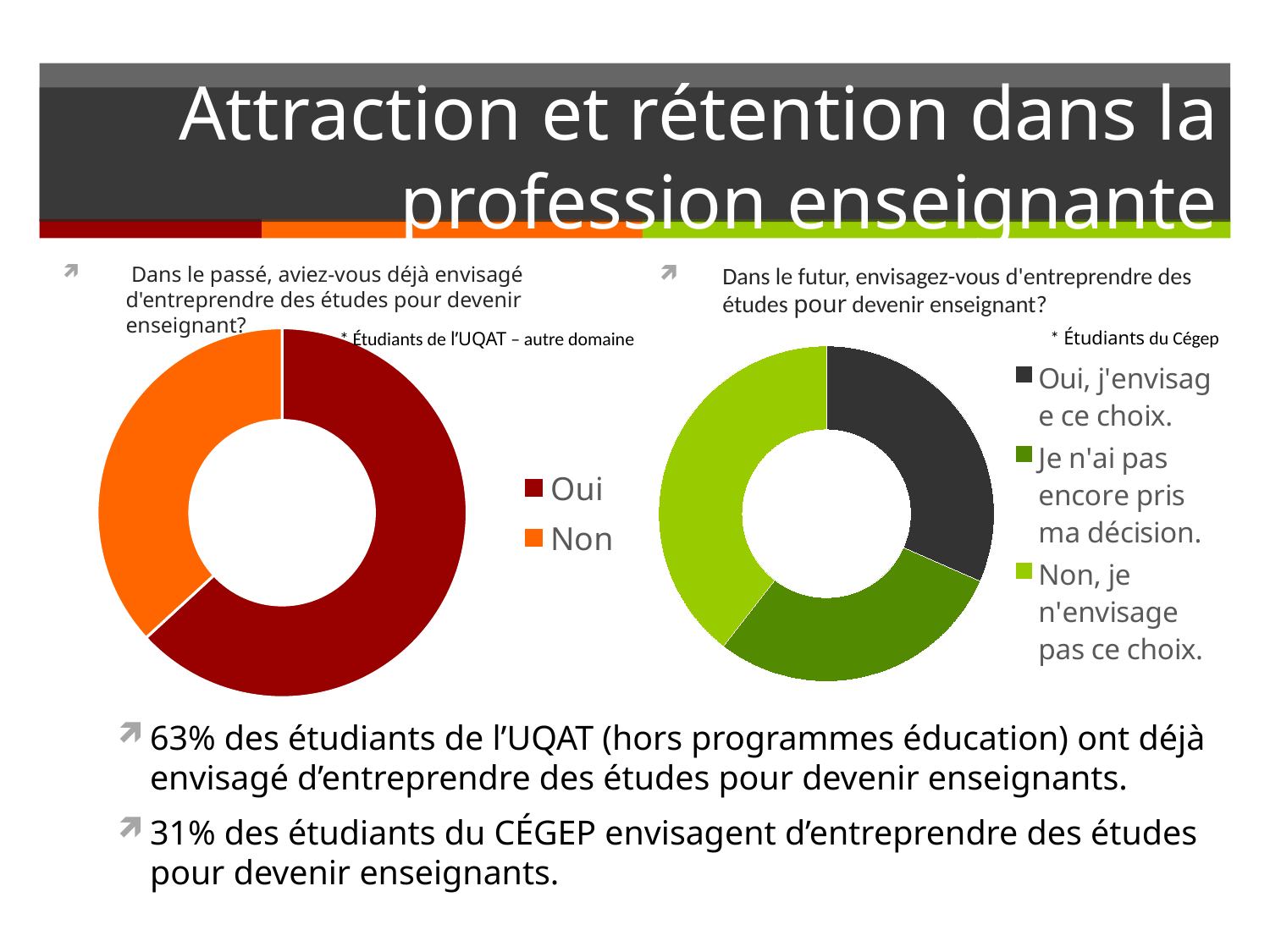
In the left chart (Étudiants de l'UQAT – autre domaine), which category has the smallest slice? Non What colour is the Oui slice in the left chart (Étudiants de l'UQAT – autre domaine)? Dark red In the left chart (Étudiants de l'UQAT – autre domaine), what share of students answered Oui? 63% In the left chart (Étudiants de l'UQAT – autre domaine), which category has the largest slice? Oui What kind of chart is the right chart (Dans le futur, envisagez-vous d'entreprendre des études pour devenir enseignant?)? Doughnut (pie) chart What kind of chart is the left chart (Dans le passé, aviez-vous déjà envisagé d'entreprendre des études pour devenir enseignant?)? Doughnut (pie) chart In the left chart (Étudiants de l'UQAT – autre domaine), which slice is larger, Oui or Non? Oui In the right chart (Étudiants du Cégep), which slice is larger, "Oui, j'envisage ce choix." or "Non, je n'envisage pas ce choix."? Non, je n'envisage pas ce choix. In the right chart (Étudiants du Cégep), which category has the largest slice? Non, je n'envisage pas ce choix. How many entries does the legend of the right chart (Étudiants du Cégep) list? 3 In the right chart (Étudiants du Cégep), what share of students answered "Oui, j'envisage ce choix."? 31% How many entries does the legend of the left chart (Étudiants de l'UQAT – autre domaine) list? 2